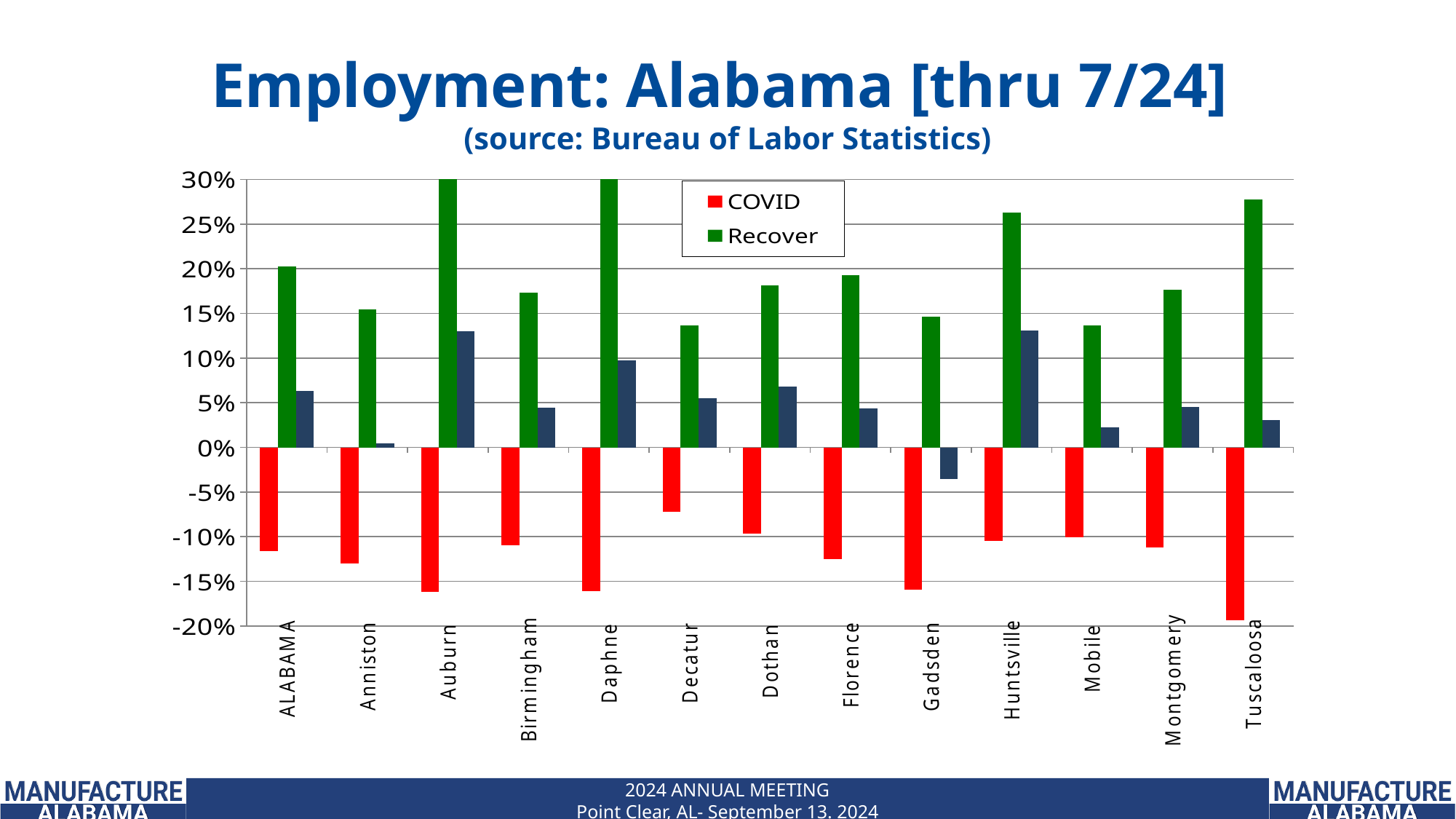
Is the COVID value for Decatur greater or less than -10%? greater Which has the larger Recover value, Huntsville or Montgomery? Huntsville What kind of chart is shown on the slide? bar chart Is the Recover value for Decatur greater or less than 15%? less Is the Recover value for Huntsville greater or less than 25%? greater Which has the larger Recover value, ALABAMA or Anniston? ALABAMA What is the title of the chart? Employment: Alabama [thru 7/24] How many series does the legend list? 2 Which category has the lowest (most negative) COVID value? Tuscaloosa What colour represents the COVID series in the legend? red How many categories are shown along the x axis? 13